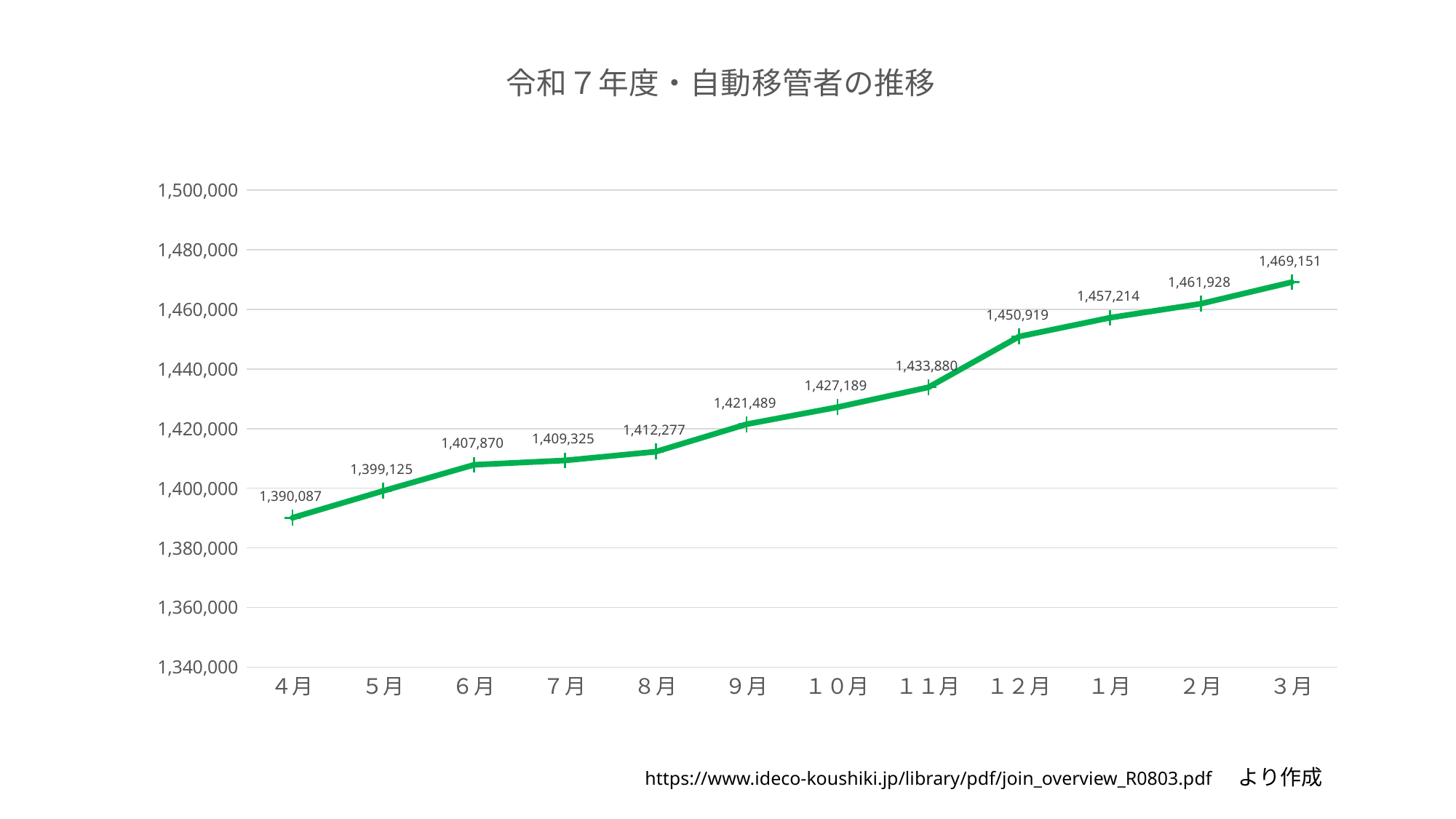
What is the value for 4月? 1,390,087 What is the difference between the values for 3月 and 4月? 79,064 Which is larger, the value for 7月 or the value for 10月? 10月 Do the values rise or fall from 4月 to 3月? Rise What kind of chart is shown on the slide? Line chart Which month has the lowest value? 4月 How many data points are plotted on the chart? 12 What is the value for 3月? 1,469,151 What is the difference between the values for 12月 and 11月? 17,039 What is the value for 12月? 1,450,919 Which month has the highest value? 3月 What is the value for 9月? 1,421,489